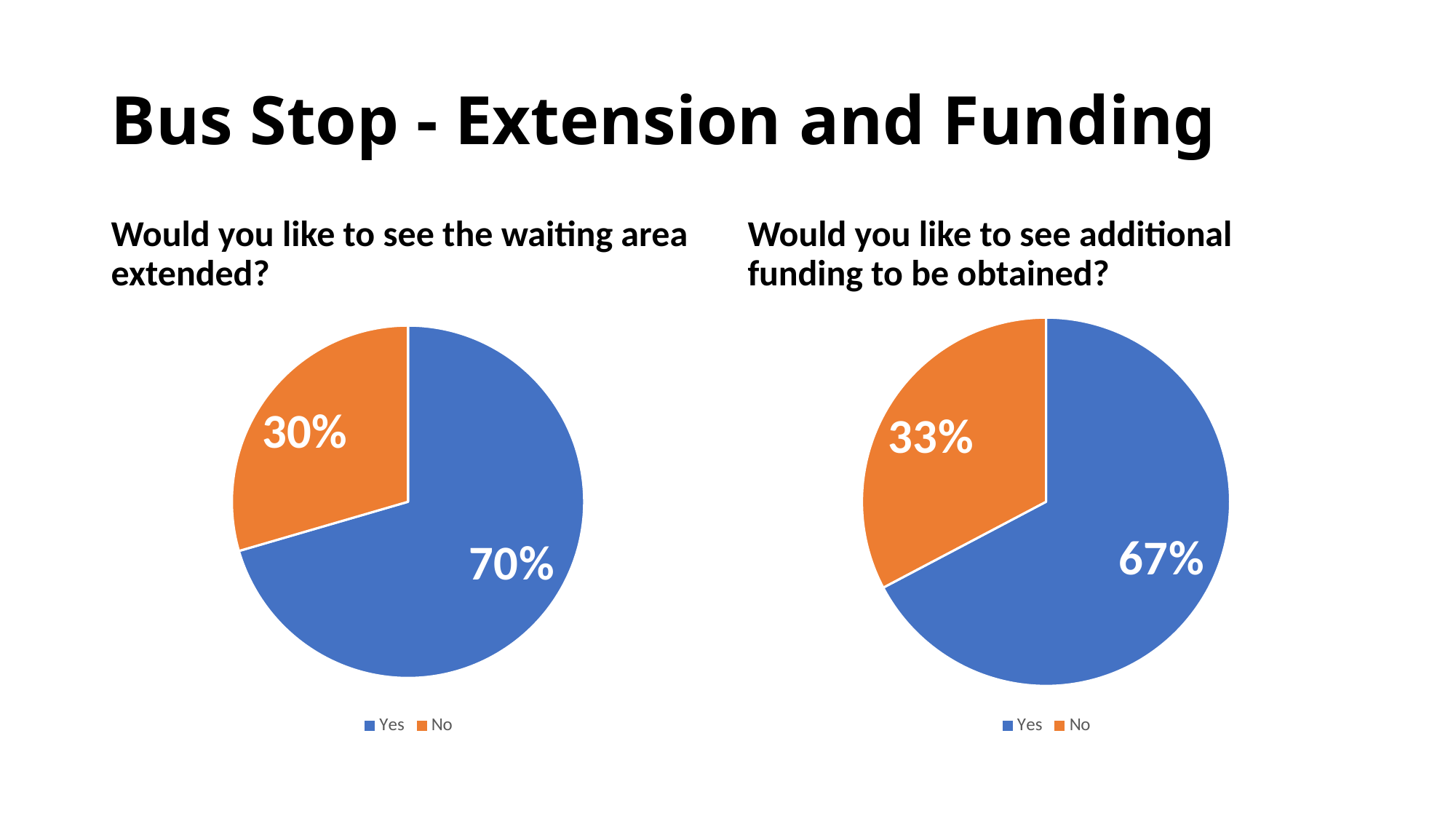
In the left pie chart (waiting area extended), what is the difference between the Yes and No shares? 40% In the right pie chart (additional funding), which response has the smallest share? No In the right pie chart (additional funding), what percentage answered Yes? 67% In the left pie chart (waiting area extended), what colour is the Yes slice? Blue In the right pie chart (additional funding), what percentage answered No? 33% How many entries does the legend of the right pie chart (additional funding) list? 2 Is the Yes share larger in the left pie chart (waiting area extended) or the right pie chart (additional funding)? Left (waiting area extended) In the right pie chart (additional funding), what is the difference between the Yes and No shares? 34% In the left pie chart (waiting area extended), what percentage answered Yes? 70% In the left pie chart (waiting area extended), which response has the largest share? Yes What type of chart is used on the left of the slide? Pie chart In the left pie chart (waiting area extended), what percentage answered No? 30%